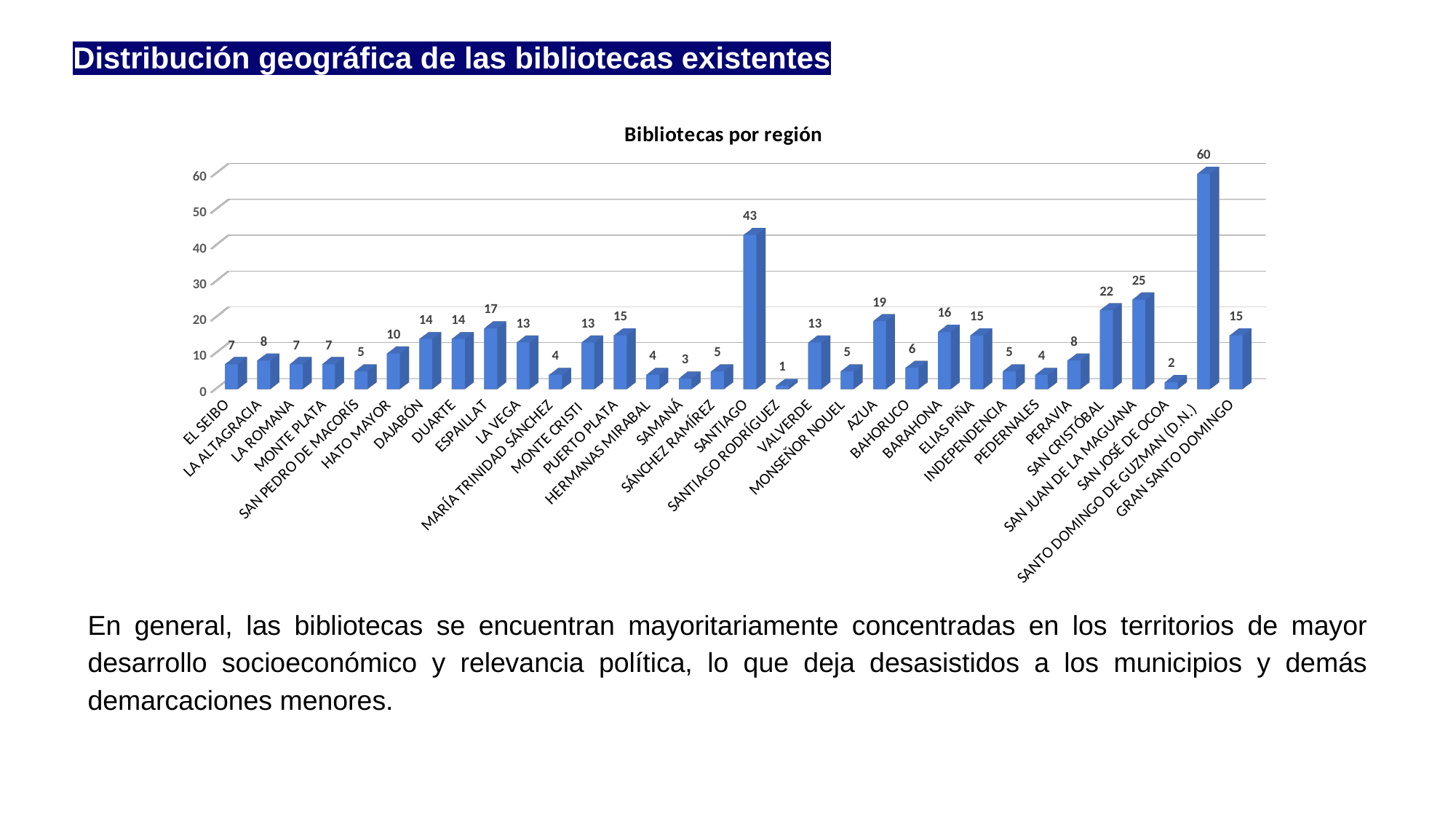
Which region has the lowest number of libraries? SANTIAGO RODRÍGUEZ What kind of chart is shown on the slide? bar chart Which region has the highest number of libraries? SANTO DOMINGO DE GUZMAN (D.N.) What is the title of the chart? Bibliotecas por región What is the value for SAN JUAN DE LA MAGUANA? 25 What is the difference between the values for AZUA and BAHORUCO? 13 What is the value for SANTIAGO? 43 What is the difference between the values for SANTO DOMINGO DE GUZMAN (D.N.) and SANTIAGO? 17 What is the value for ESPAILLAT? 17 How many regions are shown on the x axis? 32 Is the value for SANTIAGO greater or less than 40? greater Which is larger, the value for SAN CRISTÓBAL or the value for BARAHONA? SAN CRISTÓBAL